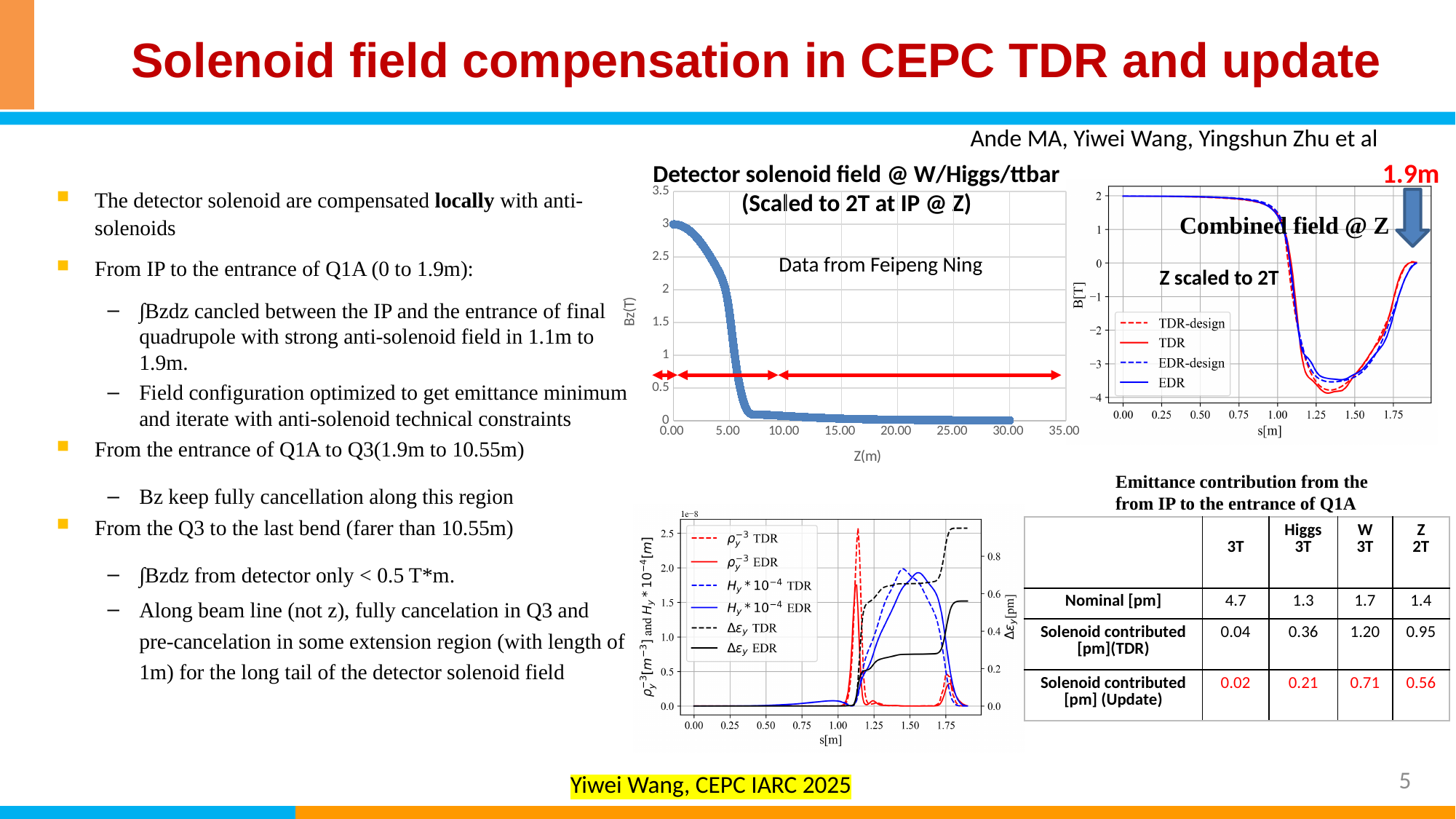
In the 'Detector solenoid field @ W/Higgs/ttbar' chart, what is the largest tick value shown on the Z axis? 35.00 In the 'Detector solenoid field @ W/Higgs/ttbar' chart, is the Bz value at Z = 0 greater or less than 2.5? greater In the bottom-centre chart, is the Δεy TDR value at s = 1.75 m greater or less than 0.8? greater In the 'Combined field @ Z' chart, is the minimum B value of the TDR curve greater or less than -3 T? less How many series does the legend of the 'Combined field @ Z' chart list? 4 In the 'Detector solenoid field @ W/Higgs/ttbar' chart, what is the label of the y axis? Bz(T) What kind of chart is the 'Combined field @ Z' chart? line chart In the bottom-centre chart, which is larger at s = 1.75 m: Δεy TDR or Δεy EDR? Δεy TDR In the 'Detector solenoid field @ W/Higgs/ttbar' chart, do the Bz values rise or fall as Z increases from 0 to 10 m? fall How many series does the legend of the bottom-centre chart (with s[m] on the x axis and Δεy on the right axis) list? 6